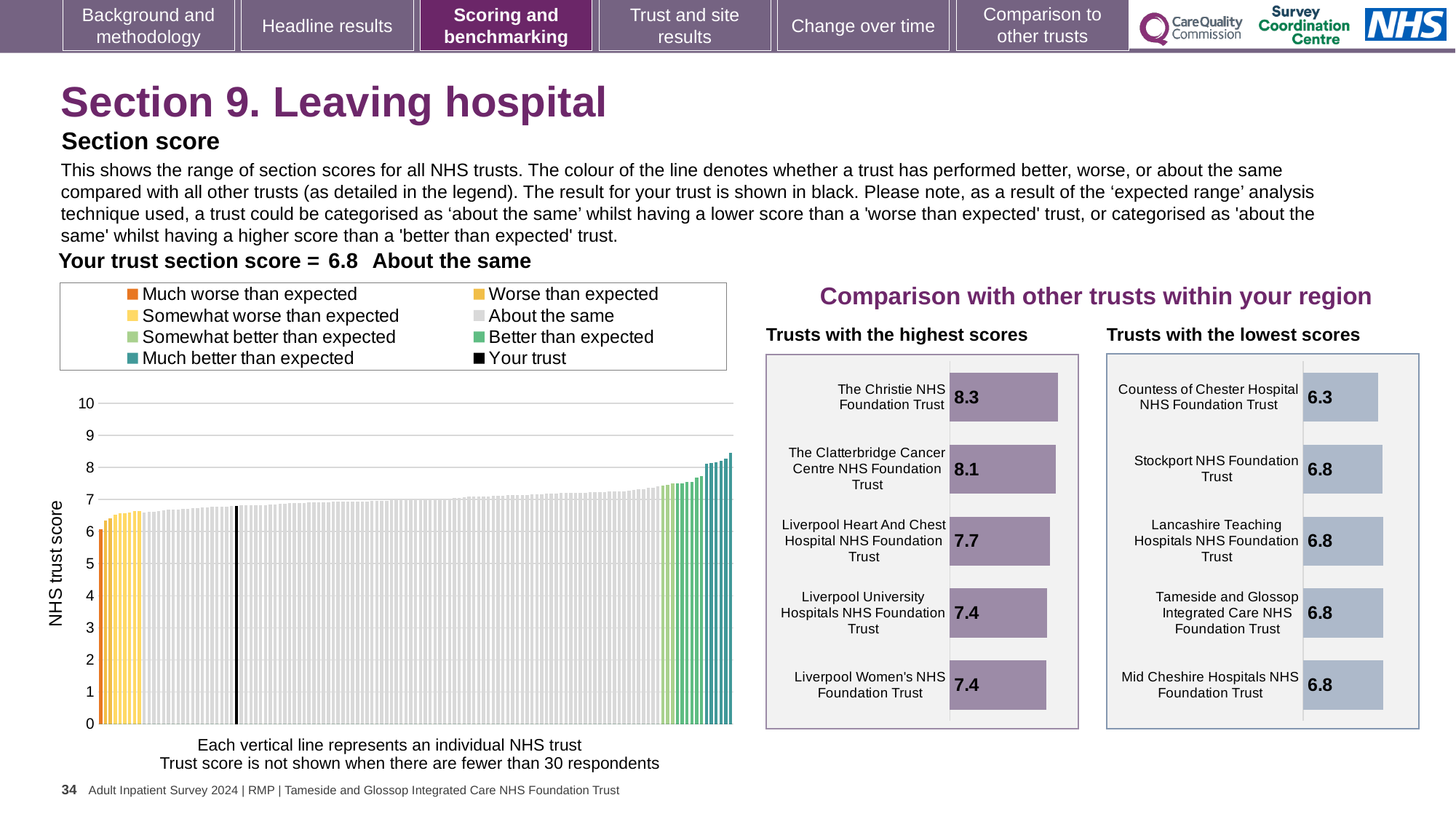
In the 'Trusts with the lowest scores' chart, which trust has the lowest score? Countess of Chester Hospital NHS Foundation Trust In the 'Trusts with the highest scores' chart, which has the higher score: Liverpool Heart And Chest Hospital NHS Foundation Trust or Liverpool University Hospitals NHS Foundation Trust? Liverpool Heart And Chest Hospital NHS Foundation Trust How many trusts are shown in the 'Trusts with the highest scores' chart? 5 In the large chart on the left, do the trust scores rise or fall from left to right? rise What kind of chart is the large chart on the left showing NHS trust scores? bar chart In the 'Trusts with the lowest scores' chart, what is the score for Countess of Chester Hospital NHS Foundation Trust? 6.3 In the 'Trusts with the highest scores' chart, which trust has the highest score? The Christie NHS Foundation Trust In the 'Trusts with the highest scores' chart, what is the difference between the scores of Liverpool Heart And Chest Hospital NHS Foundation Trust and Liverpool Women's NHS Foundation Trust? 0.3 In the 'Trusts with the lowest scores' chart, what is the score for Stockport NHS Foundation Trust? 6.8 How many entries does the legend above the large chart on the left list? 8 In the 'Trusts with the highest scores' chart, what is the score for The Christie NHS Foundation Trust? 8.3 In the 'Trusts with the highest scores' chart, what is the difference between the scores of The Christie NHS Foundation Trust and The Clatterbridge Cancer Centre NHS Foundation Trust? 0.2